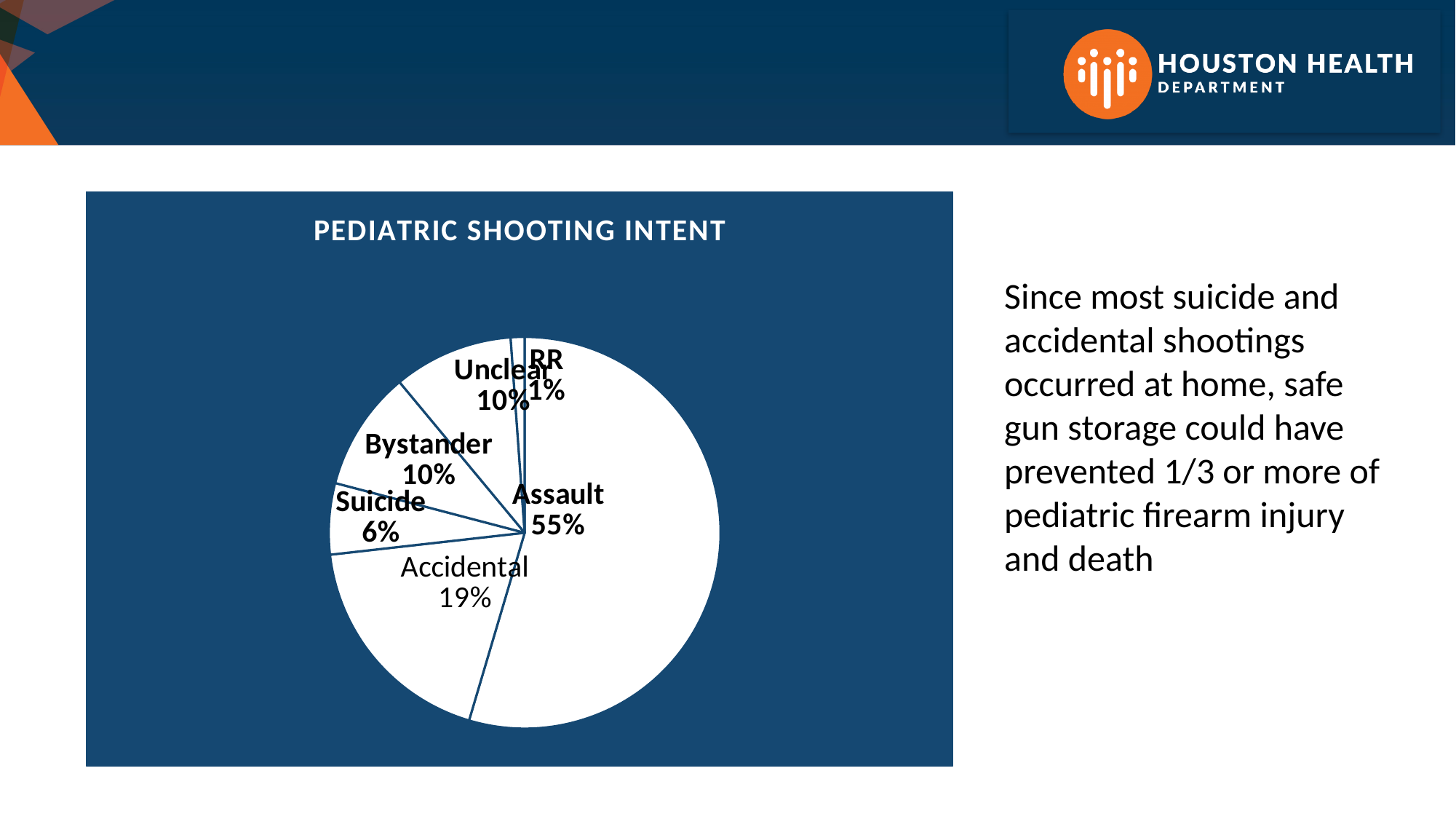
What type of chart is shown on the slide? Pie chart What percentage is shown for Bystander? 10% Which is larger, the Accidental slice or the Suicide slice? Accidental What percentage of the pie is labelled Accidental? 19% What is the title of the chart? PEDIATRIC SHOOTING INTENT Which category has the largest slice of the pie? Assault What is the value shown for RR? 1% What is the value shown for Suicide? 6% Which category has the smallest slice of the pie? RR What share of pediatric shootings is attributed to Assault? 55% How many categories are shown in the pie chart? 6 What is the difference in percentage points between Assault and Accidental? 36